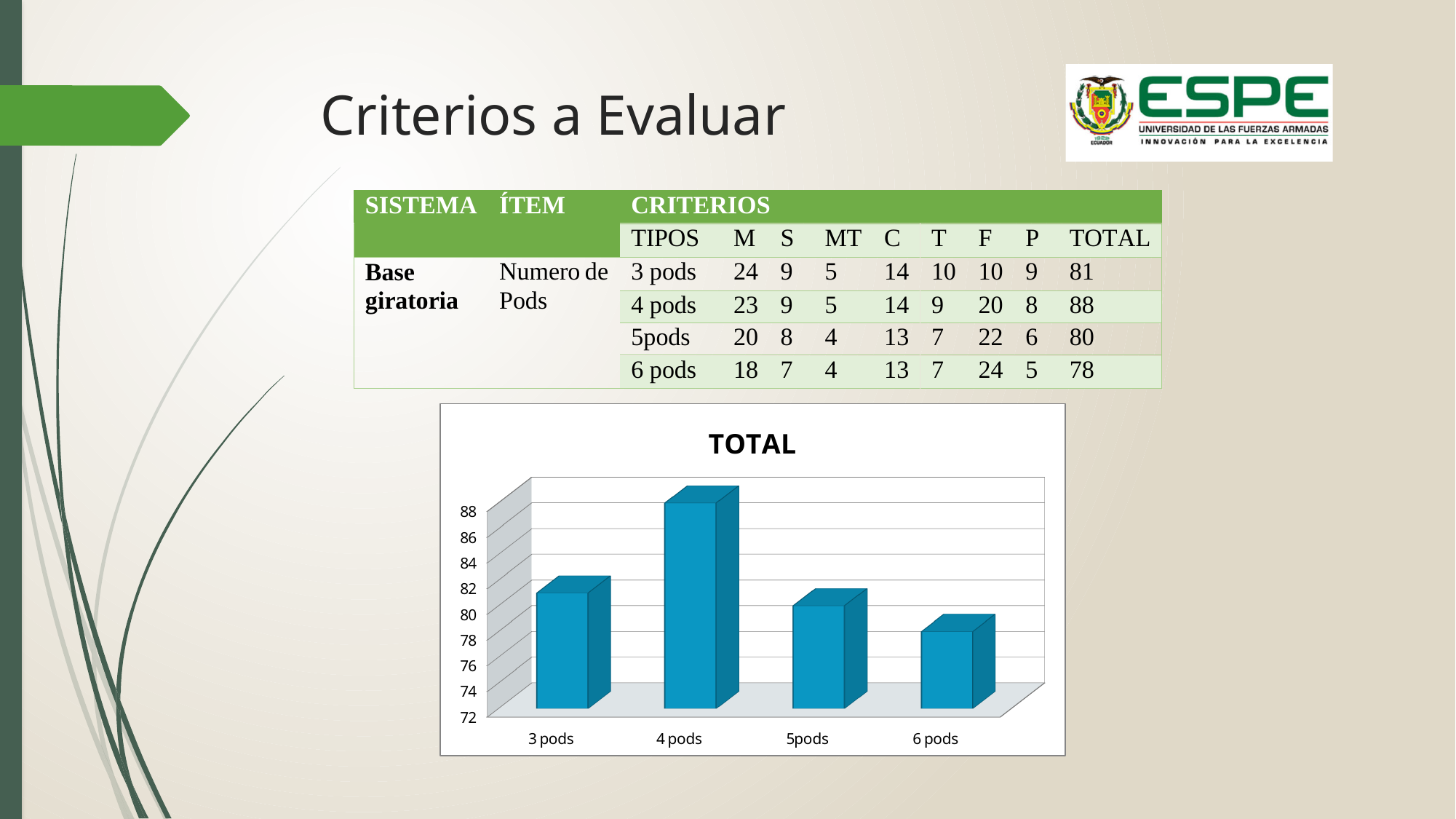
What is the TOTAL value for 6 pods? 78 What is the lowest value shown on the vertical axis of the TOTAL chart? 72 What is the title of the chart? TOTAL What is the TOTAL value for 5pods? 80 Which category has the highest bar in the TOTAL chart? 4 pods What kind of chart is shown on the slide? bar chart Which has a larger TOTAL value, 3 pods or 4 pods? 4 pods What is the TOTAL value for 4 pods? 88 Which category has the lowest bar in the TOTAL chart? 6 pods What is the difference between the TOTAL values for 4 pods and 6 pods? 10 How many categories are plotted in the TOTAL chart? 4 Is the value for 3 pods greater or less than 84? less